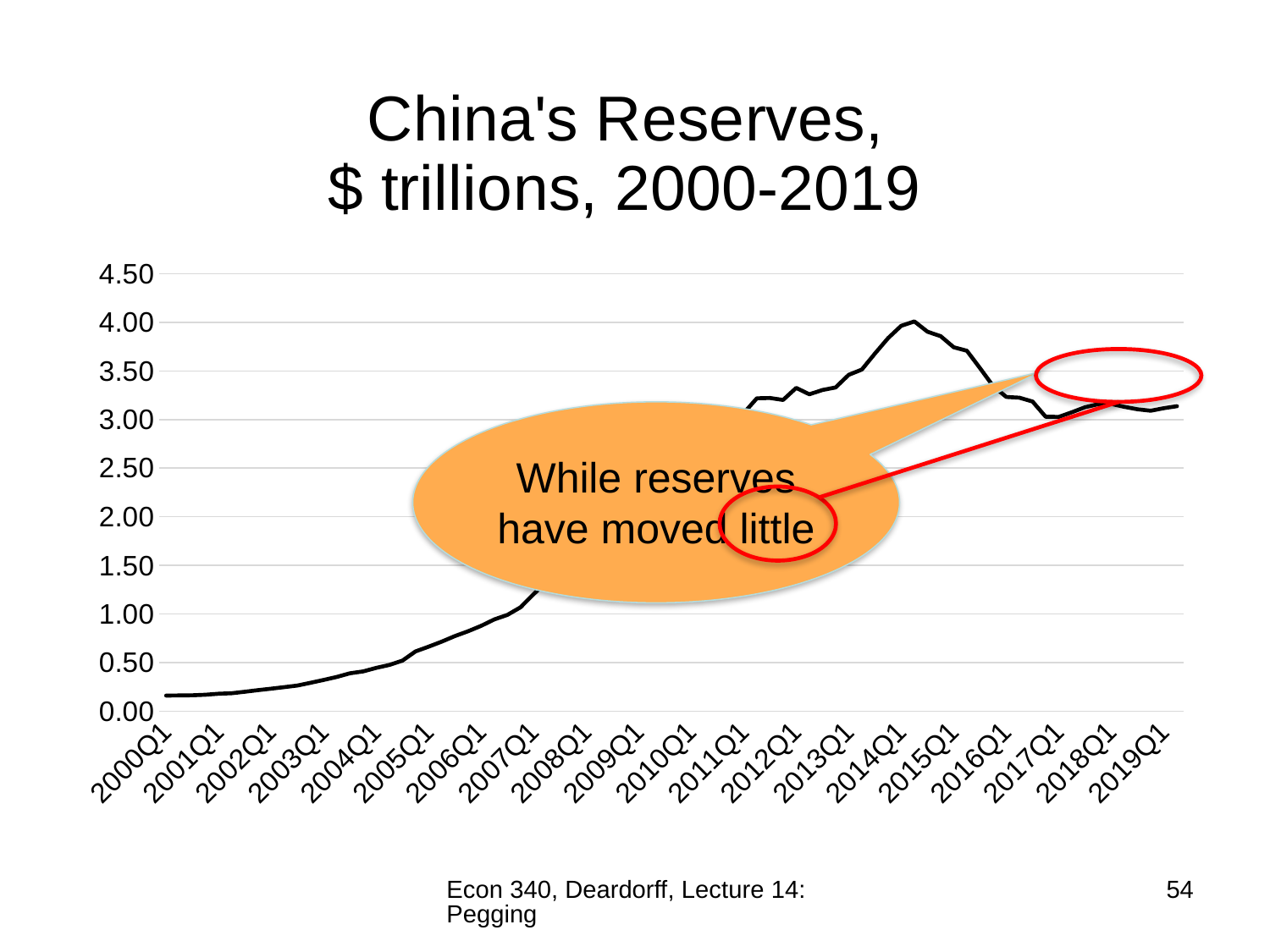
Which is larger, the value for 2000Q1 or the value for 2019Q1? 2019Q1 Is the value for 2000Q1 greater or less than 0.50? less What text appears in the orange callout on the chart? While reserves have moved little What is the title of the chart? China's Reserves, $ trillions, 2000-2019 Is the highest point of the line greater or less than 3.50? greater How many year labels are shown on the x axis? 20 Is the value for 2005Q1 greater or less than 1.00? less Do reserves rise or fall between the peak in 2014 and 2017Q1? fall What kind of chart is shown on the slide? line chart Do reserves rise or fall between 2000Q1 and 2007Q1? rise